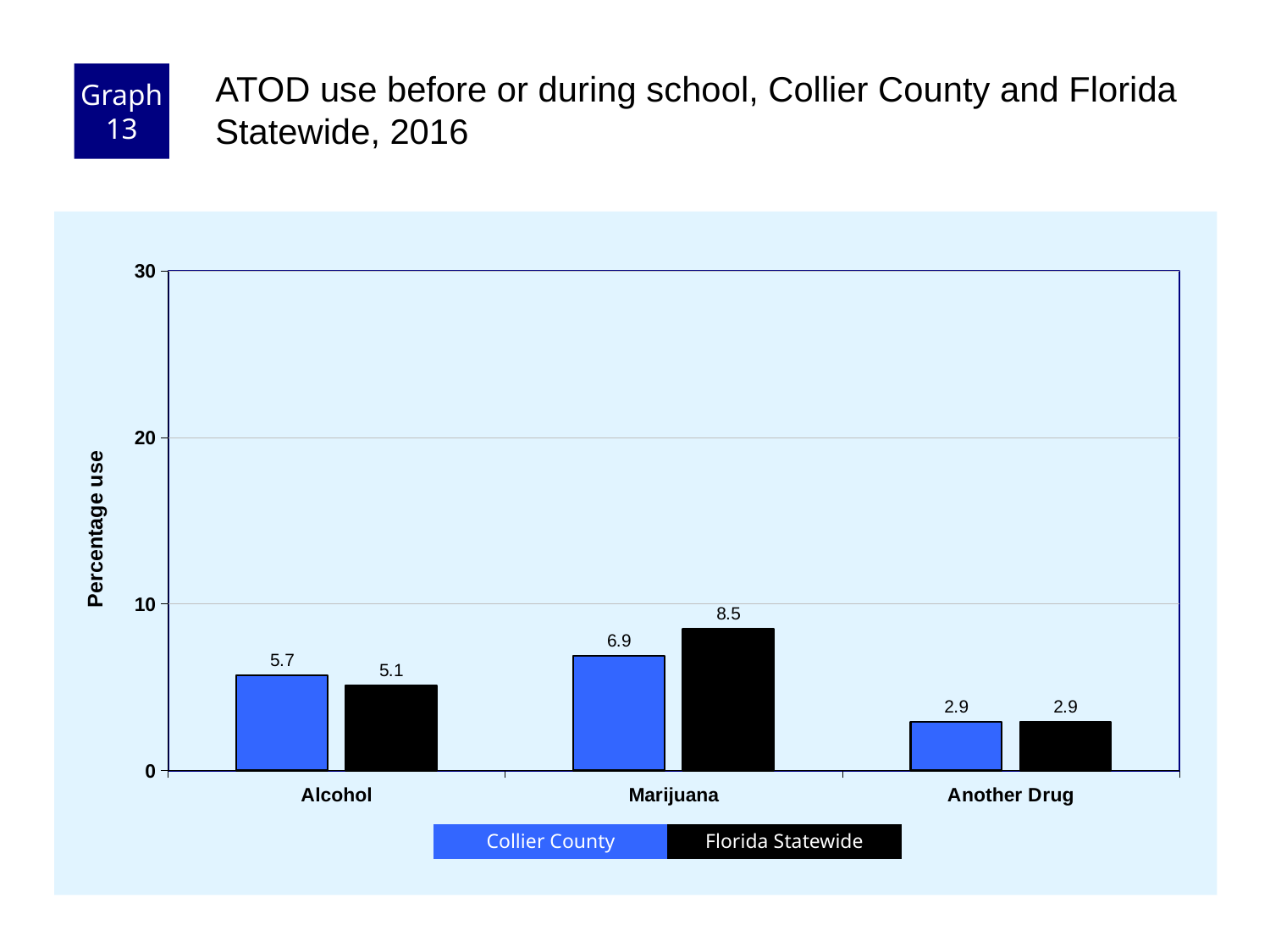
What kind of chart is shown on the slide? bar chart What is the Collier County value for Another Drug? 2.9 How many categories are shown on the x axis? 3 What is the Florida Statewide value for Marijuana? 8.5 How many series does the legend list? 2 Which category has the highest Florida Statewide value? Marijuana Which is larger for Alcohol, the Collier County value or the Florida Statewide value? Collier County What is the difference between the Collier County and Florida Statewide values for Alcohol? 0.6 What is the Collier County value for Alcohol? 5.7 Is the Florida Statewide value for Marijuana greater or less than 10? less What is the difference between the Florida Statewide and Collier County values for Marijuana? 1.6 Which category has the lowest Collier County value? Another Drug